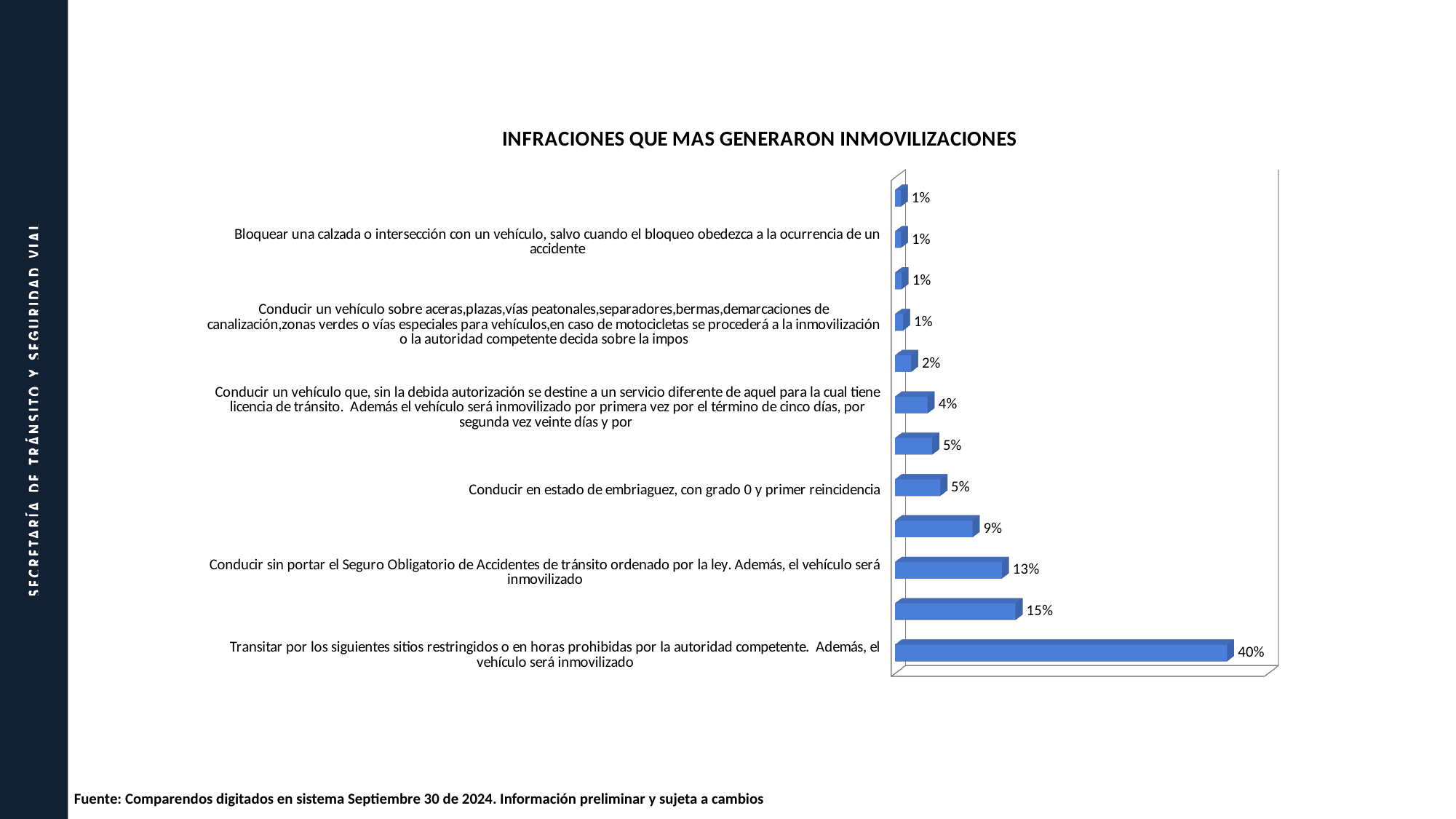
What is the difference between the value for 'Conducir sin portar el Seguro Obligatorio' and the value for 'Conducir en estado de embriaguez'? 8 percentage points What is the value for 'Conducir en estado de embriaguez, con grado 0 y primer reincidencia'? 5% What kind of chart is shown on the slide? Bar chart How many bars are plotted in the chart? 12 Which is larger: the value for 'Conducir en estado de embriaguez' or the value for 'Conducir un vehículo que, sin la debida autorización se destine a un servicio diferente'? Conducir en estado de embriaguez What is the value for 'Bloquear una calzada o intersección con un vehículo, salvo cuando el bloqueo obedezca a la ocurrencia de un accidente'? 1% What is the difference between the value for 'Transitar por los siguientes sitios restringidos' and the value for 'Conducir sin portar el Seguro Obligatorio'? 27 percentage points What is the value for 'Transitar por los siguientes sitios restringidos o en horas prohibidas por la autoridad competente'? 40% What is the title of the chart? INFRACIONES QUE MAS GENERARON INMOVILIZACIONES What is the value for 'Conducir un vehículo que, sin la debida autorización se destine a un servicio diferente de aquel para la cual tiene licencia de tránsito'? 4% Which category has the highest value? Transitar por los siguientes sitios restringidos o en horas prohibidas por la autoridad competente. Además, el vehículo será inmovilizado What is the value for 'Conducir sin portar el Seguro Obligatorio de Accidentes de tránsito ordenado por la ley'? 13%